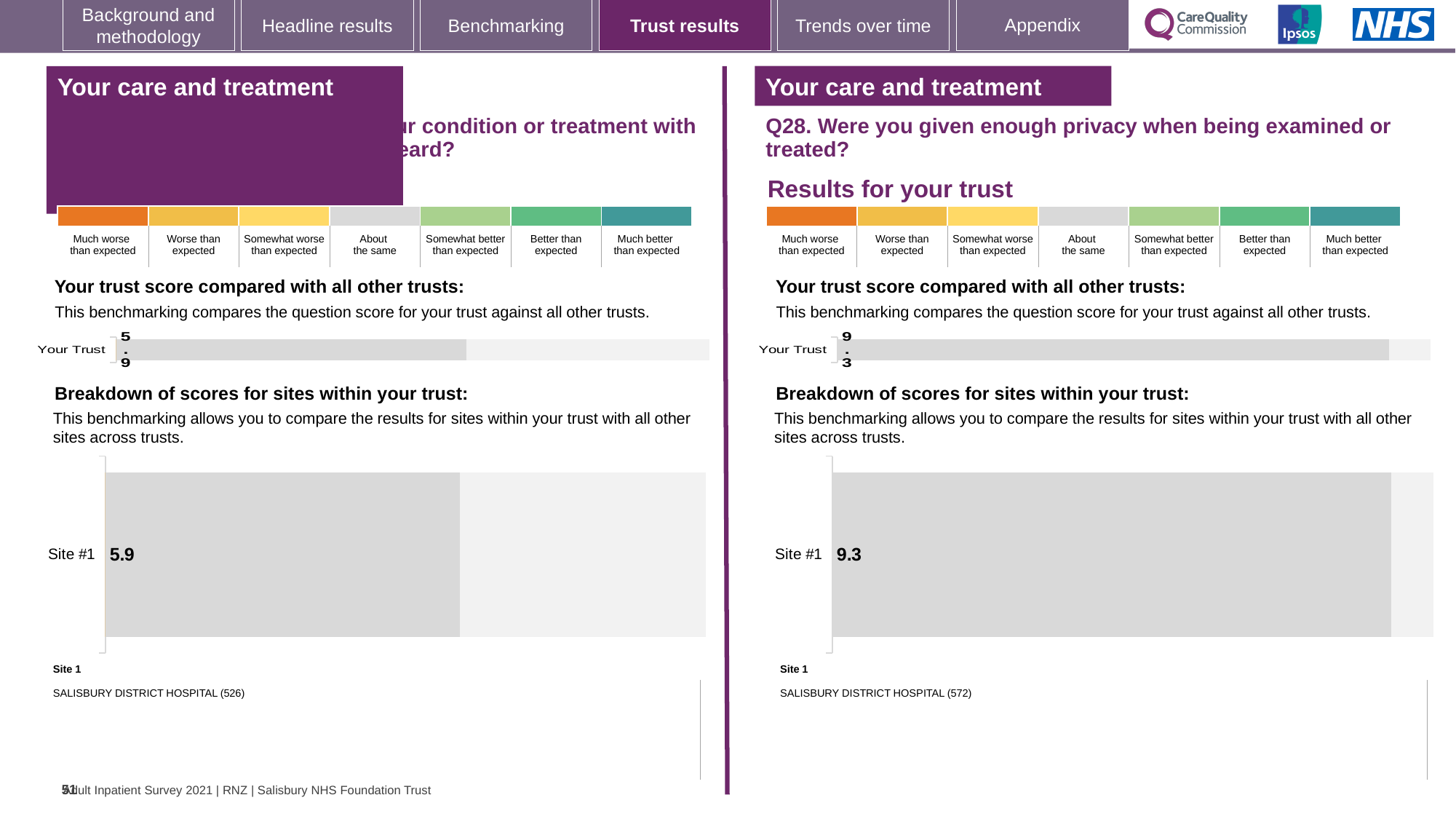
On the right panel (Q28), what is the difference between the Your Trust score and the Site #1 score? 0 How many sites are shown in the left panel's 'Breakdown of scores for sites within your trust' chart? 1 On the right panel (Q28), which hospital is listed as Site 1? SALISBURY DISTRICT HOSPITAL What kind of chart is used for the 'Breakdown of scores for sites within your trust' on the right panel? Bar chart On the left panel's 'Your trust score compared with all other trusts' chart, is the Your Trust score greater or less than 9? less Which panel's Site #1 score is larger, the left panel or the right panel (Q28)? Right panel (Q28) What is the difference between the Site #1 score on the right panel (Q28) and the Site #1 score on the left panel? 3.4 On the left panel's 'Your trust score compared with all other trusts' chart, what is the score for Your Trust? 5.9 On the left panel, what number appears in parentheses after SALISBURY DISTRICT HOSPITAL for Site 1? 526 On the right panel (Q28) 'Breakdown of scores for sites within your trust' chart, what is the score for Site #1? 9.3 On the left panel's 'Breakdown of scores for sites within your trust' chart, what is the score for Site #1? 5.9 On the right panel (Q28) 'Your trust score compared with all other trusts' chart, what is the score for Your Trust? 9.3